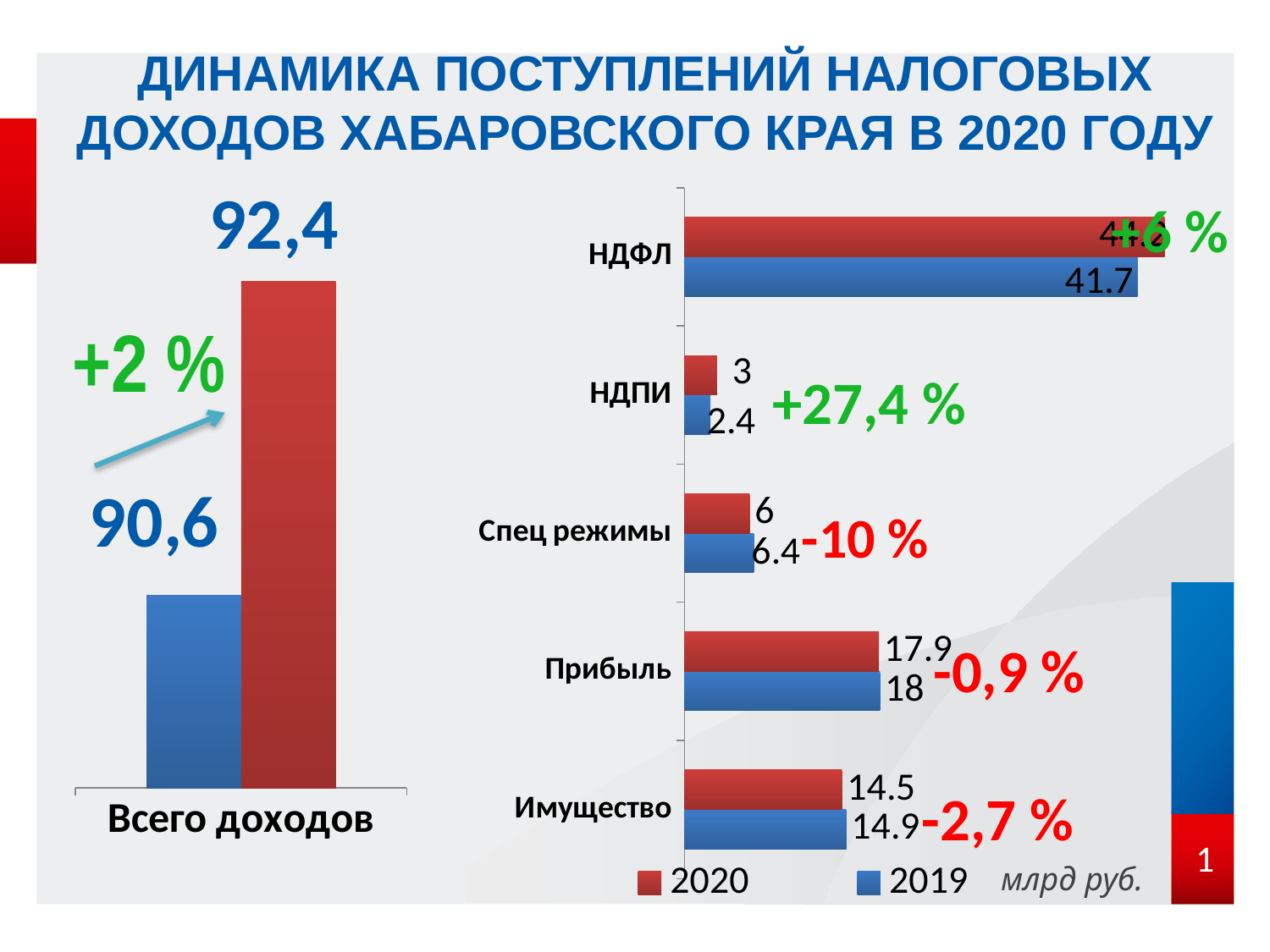
On the right chart, which category has the highest 2019 value? НДФЛ On the left chart (Всего доходов), what percentage change is shown between the two bars? +2 % On the left chart (Всего доходов), what is the value of the blue 2019 bar? 90,6 On the right chart, what is the 2019 value for НДФЛ? 41.7 On the left chart (Всего доходов), what is the value of the red 2020 bar? 92,4 On the right chart, what is the difference between the 2019 and 2020 values for Прибыль? 0.1 On the right chart, how many series does the legend list? 2 On the right chart, how many categories are shown? 5 On the right chart, what is the 2019 value for Спец режимы? 6.4 On the right chart, which category has the lowest 2019 value? НДПИ On the right chart, what is the 2020 value for Имущество? 14.5 On the right chart, what is the 2020 value for НДПИ? 3